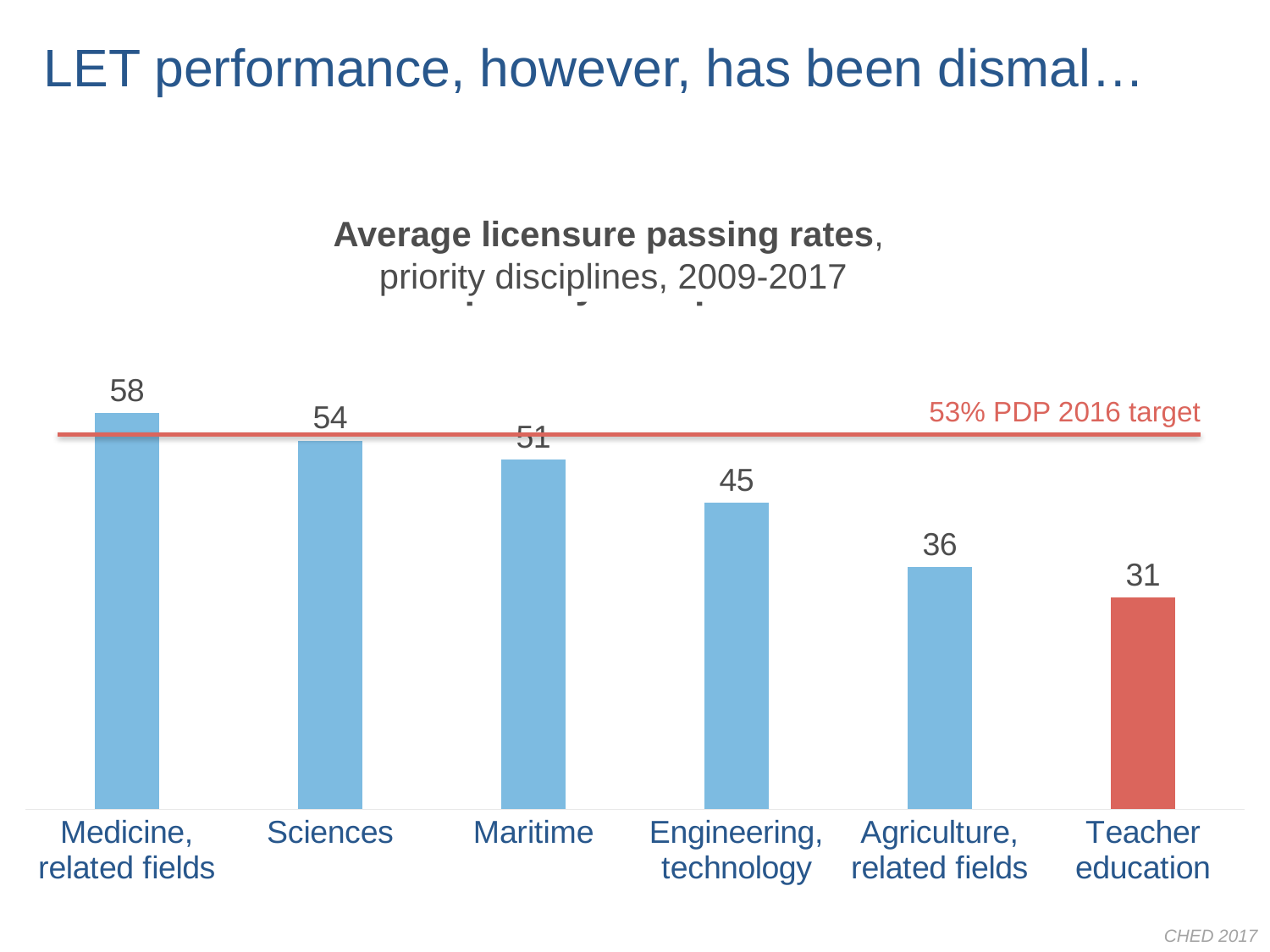
Which has a higher passing rate, Maritime or Engineering, technology? Maritime Do the values rise or fall from left to right across the disciplines? Fall What is the difference between the passing rates for Sciences and Agriculture, related fields? 18 What is the average licensure passing rate for Teacher education? 31 What is the average licensure passing rate for Medicine, related fields? 58 Which discipline has the lowest average licensure passing rate? Teacher education How many disciplines are shown in the chart? 6 Which discipline's bar is coloured red instead of blue? Teacher education Which discipline has the highest average licensure passing rate? Medicine, related fields What kind of chart is shown on the slide? Bar chart What is the value shown for Engineering, technology? 45 What target value does the horizontal red line represent? 53% PDP 2016 target